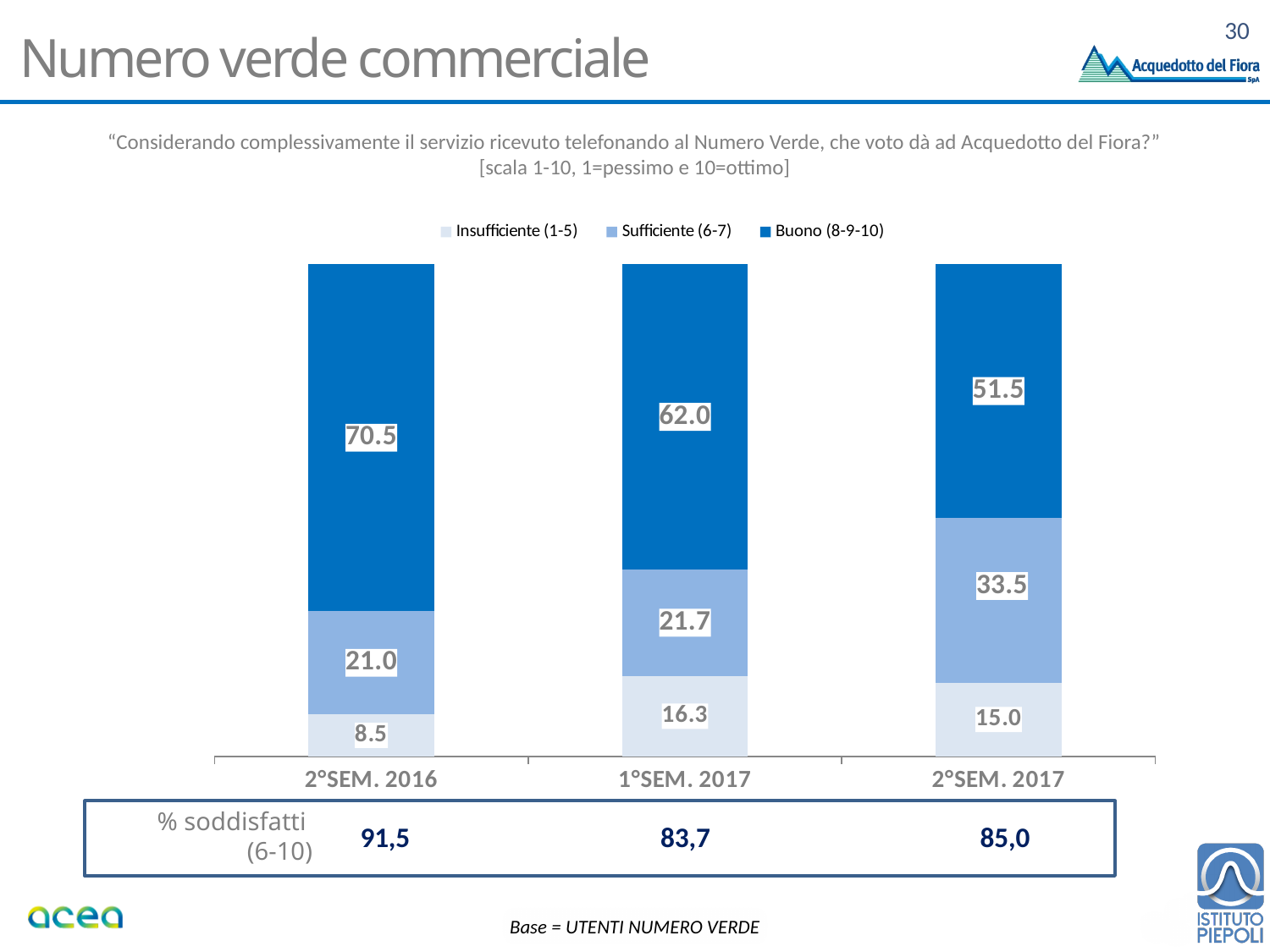
What is the difference between the Buono (8-9-10) values for 2°SEM. 2016 and 2°SEM. 2017? 19.0 What is the value for Insufficiente (1-5) in 1°SEM. 2017? 16.3 Does the Buono (8-9-10) value rise or fall from 2°SEM. 2016 to 2°SEM. 2017? Fall What kind of chart is shown on the slide? Stacked bar chart What is the % soddisfatti (6-10) value shown for 1°SEM. 2017? 83,7 Which is larger: the Sufficiente (6-7) value in 1°SEM. 2017 or in 2°SEM. 2017? 2°SEM. 2017 How many series does the legend list? 3 In which period is the Buono (8-9-10) value highest? 2°SEM. 2016 What is the value for Sufficiente (6-7) in 2°SEM. 2017? 33.5 In which period is the Insufficiente (1-5) value lowest? 2°SEM. 2016 What is the value for Buono (8-9-10) in 2°SEM. 2016? 70.5 How many periods are shown on the x axis? 3